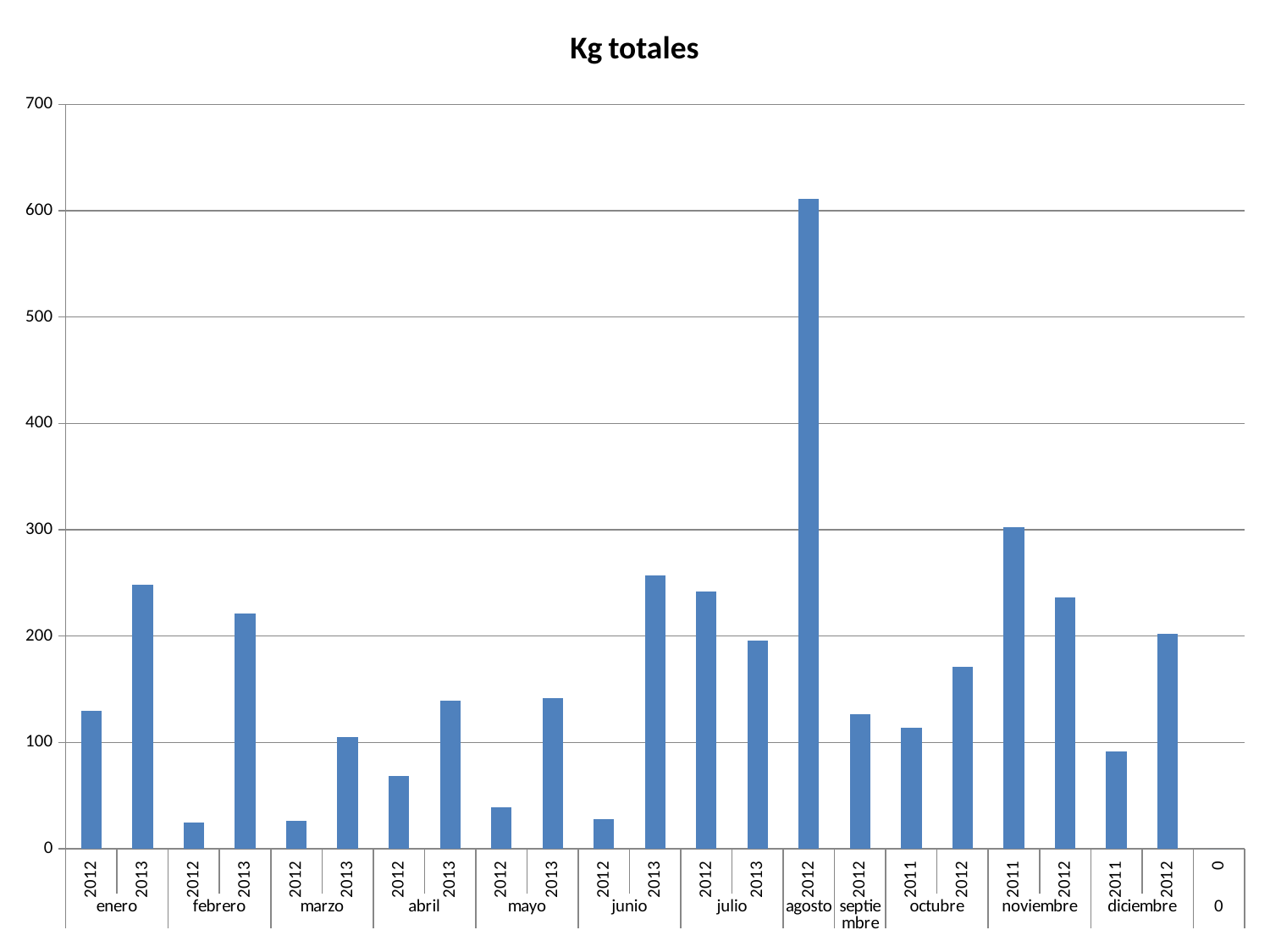
What is the title of the chart? Kg totales Is the value for julio 2012 greater or less than 200? greater Is the value for agosto 2012 greater or less than 500? greater Which is larger, the value for noviembre 2011 or noviembre 2012? noviembre 2011 Is the value for diciembre 2011 greater or less than 100? less Which is larger, the value for enero 2012 or enero 2013? enero 2013 Which bar has the highest value in the chart? agosto 2012 What kind of chart is shown on the slide? bar chart Which is larger, the value for julio 2012 or julio 2013? julio 2012